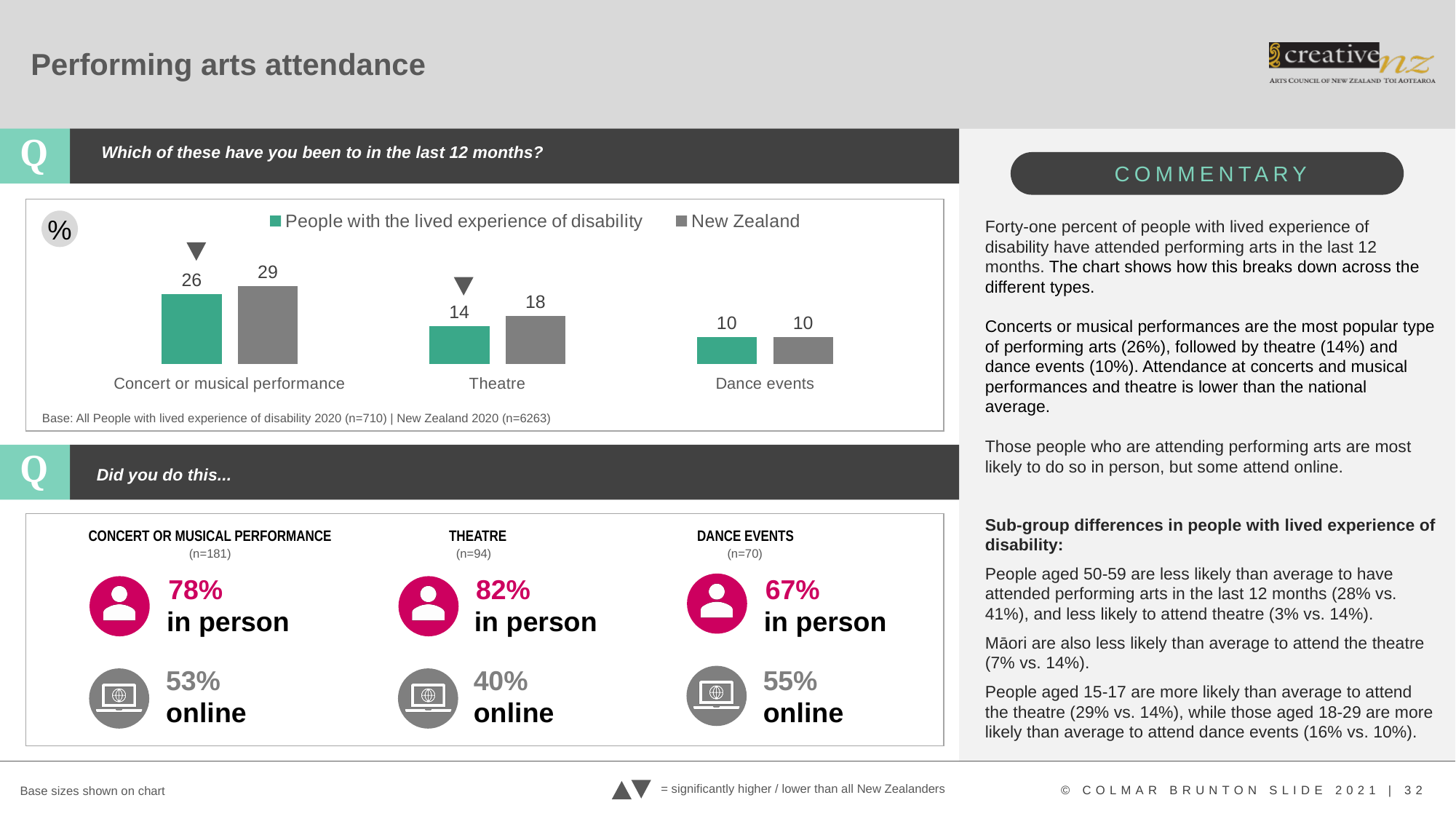
In the bar chart, what is the value for 'People with the lived experience of disability' for Concert or musical performance? 26 In the bar chart, do the values for 'People with the lived experience of disability' rise or fall from Concert or musical performance to Dance events? Fall In the bar chart, which category has the lowest value for 'People with the lived experience of disability'? Dance events What type of chart is shown under the question 'Which of these have you been to in the last 12 months?' Bar chart In the bar chart, which is larger for Concert or musical performance: the 'People with the lived experience of disability' value or the 'New Zealand' value? New Zealand How many categories are shown on the x axis of the bar chart? 3 In the bar chart, what is the difference between the 'New Zealand' and 'People with the lived experience of disability' values for Theatre? 4 In the bar chart, which category has the highest value for 'New Zealand'? Concert or musical performance What colour are the bars for 'People with the lived experience of disability' in the bar chart? Green How many series does the legend of the bar chart list? 2 In the bar chart, what is the value for 'People with the lived experience of disability' for Dance events? 10 In the bar chart, what is the value for 'New Zealand' for Theatre? 18